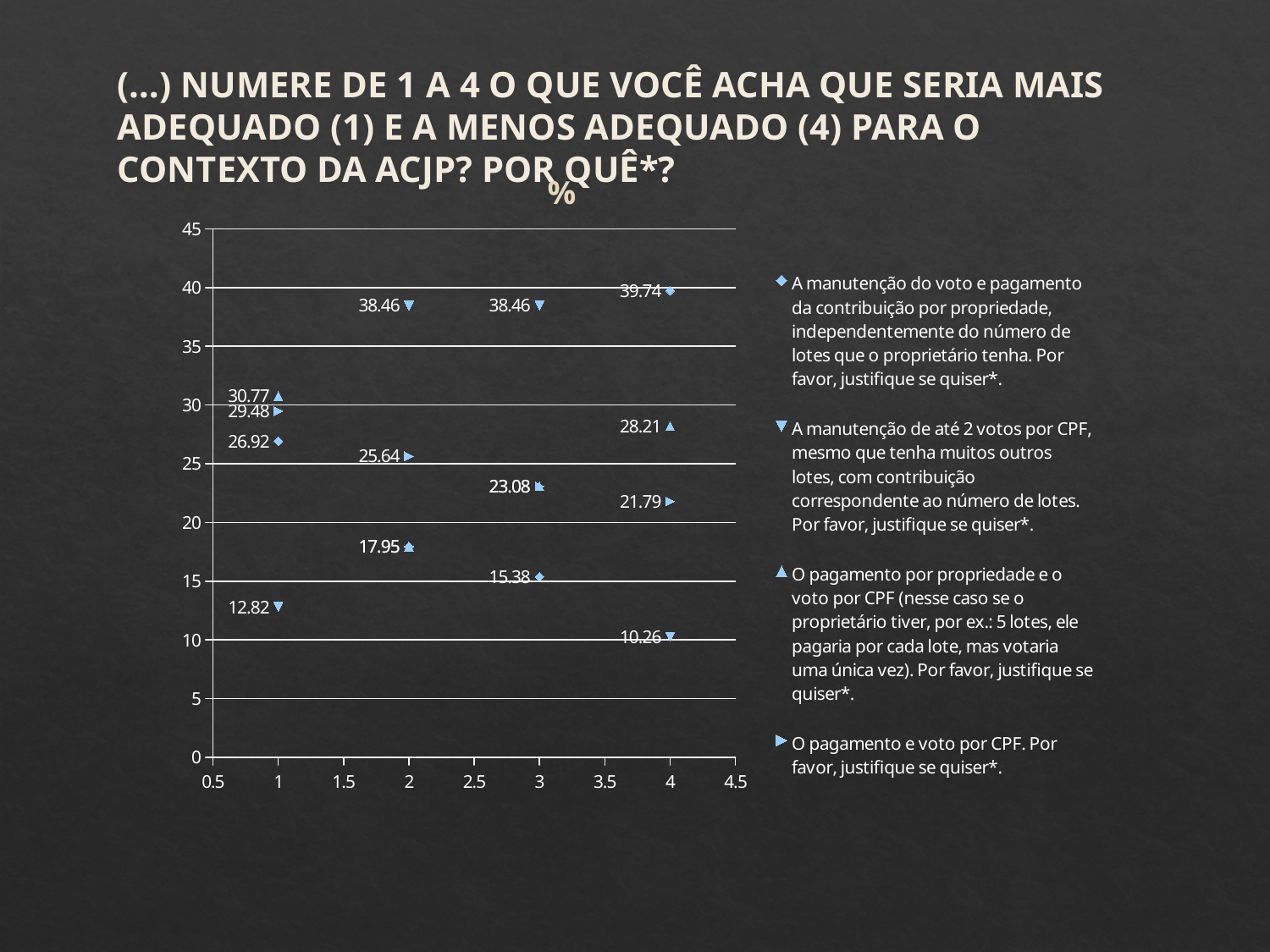
What is the value at x = 1 for the series 'A manutenção de até 2 votos por CPF...'? 12.82 What is the value at x = 4 for the series 'A manutenção do voto e pagamento da contribuição por propriedade...'? 39.74 What is the difference between the values at x = 2 and x = 4 for the series 'A manutenção de até 2 votos por CPF...'? 28.20 What kind of chart is shown on the slide? Scatter chart Is the value at x = 3 for the series 'A manutenção de até 2 votos por CPF...' greater or less than 35? greater Which series has the highest value at x = 4? A manutenção do voto e pagamento da contribuição por propriedade, independentemente do número de lotes que o proprietário tenha What is the value at x = 4 for the series 'O pagamento por propriedade e o voto por CPF...'? 28.21 How many series does the chart legend list? 4 Which series has the lowest value at x = 4? A manutenção de até 2 votos por CPF, mesmo que tenha muitos outros lotes, com contribuição correspondente ao número de lotes What is the value at x = 2 for the series 'O pagamento e voto por CPF'? 25.64 At x = 1, which is larger: the value for 'O pagamento por propriedade e o voto por CPF...' or the value for 'A manutenção do voto e pagamento da contribuição por propriedade...'? O pagamento por propriedade e o voto por CPF What is the title of the chart? %